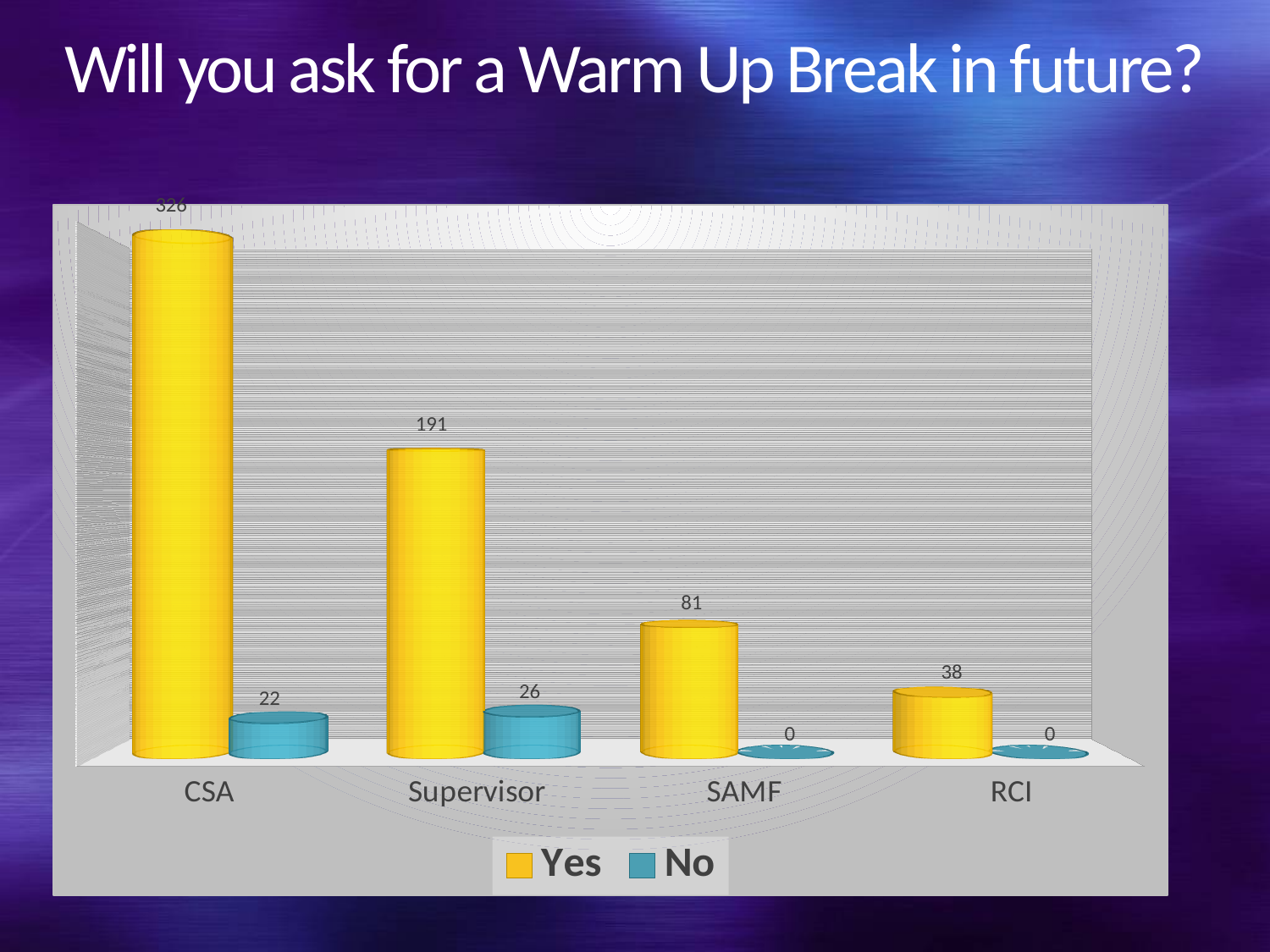
How many series does the legend list? 2 How many categories are shown on the x axis? 4 What is the Yes value for CSA? 326 What is the difference between the Yes values for Supervisor and SAMF? 110 What is the No value for RCI? 0 Which is larger, the No value for CSA or the No value for Supervisor? Supervisor Which category has the highest Yes value? CSA What kind of chart is shown on the slide? Bar chart Which category has the lowest Yes value? RCI What is the difference between the Yes and No values for CSA? 304 What is the Yes value for SAMF? 81 What is the No value for Supervisor? 26